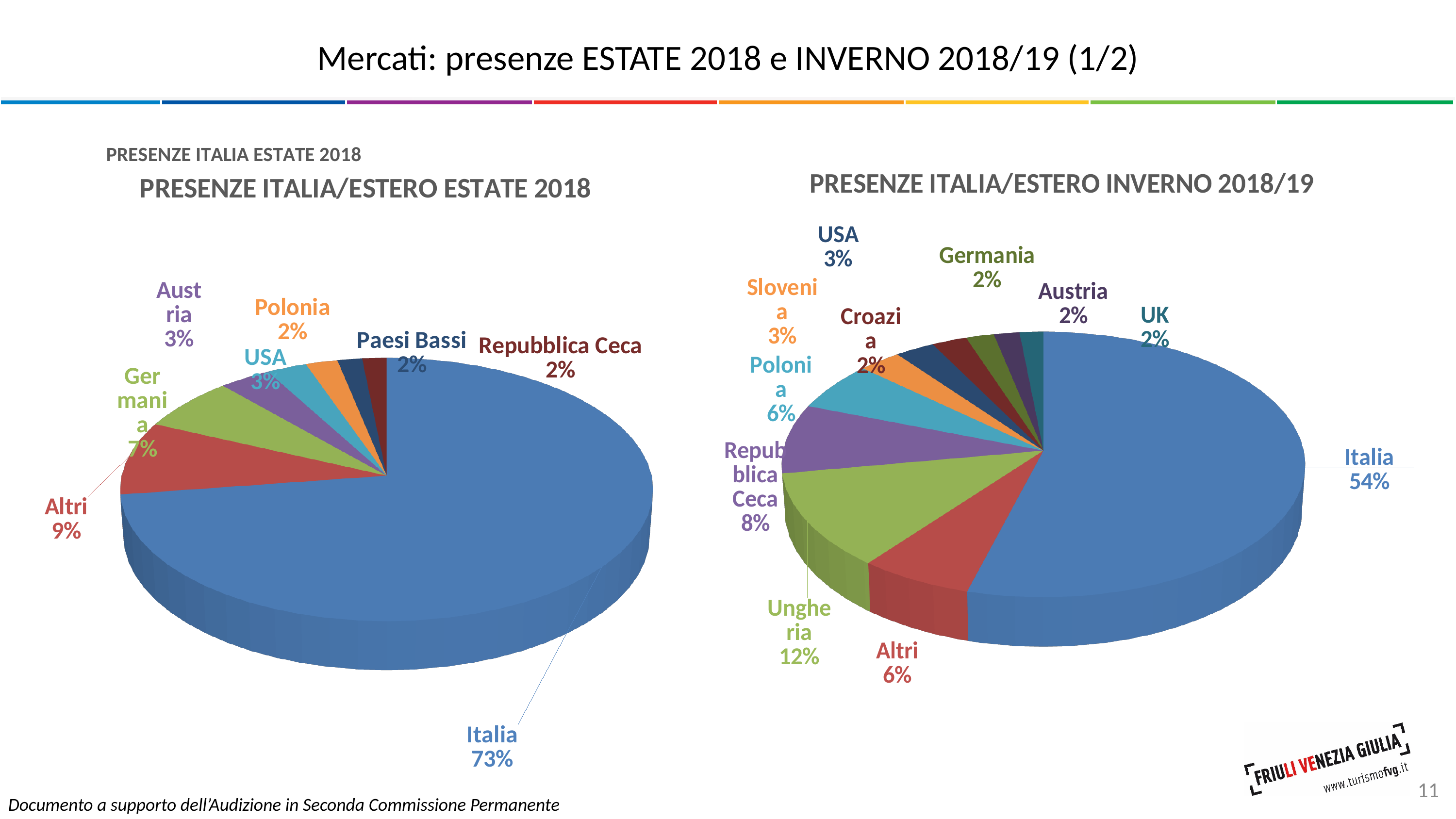
In the PRESENZE ITALIA/ESTERO INVERNO 2018/19 chart, which category has the second largest slice after Italia? Ungheria What is the difference between Italia's share in the ESTATE 2018 chart and Italia's share in the INVERNO 2018/19 chart? 19 percentage points What type of chart is used for PRESENZE ITALIA/ESTERO ESTATE 2018? Pie chart In the PRESENZE ITALIA/ESTERO INVERNO 2018/19 chart, what share does Italia have? 54% How many slices does the PRESENZE ITALIA/ESTERO ESTATE 2018 pie chart have? 8 In the PRESENZE ITALIA/ESTERO INVERNO 2018/19 chart, which is larger: Polonia or Slovenia? Polonia In the PRESENZE ITALIA/ESTERO ESTATE 2018 chart, what share does Italia have? 73% How many slices does the PRESENZE ITALIA/ESTERO INVERNO 2018/19 pie chart have? 11 In the PRESENZE ITALIA/ESTERO INVERNO 2018/19 chart, what share does Repubblica Ceca have? 8% In the PRESENZE ITALIA/ESTERO ESTATE 2018 chart, which category has the largest slice? Italia In the PRESENZE ITALIA/ESTERO INVERNO 2018/19 chart, what share does Ungheria have? 12% In the PRESENZE ITALIA/ESTERO ESTATE 2018 chart, what share does Germania have? 7%